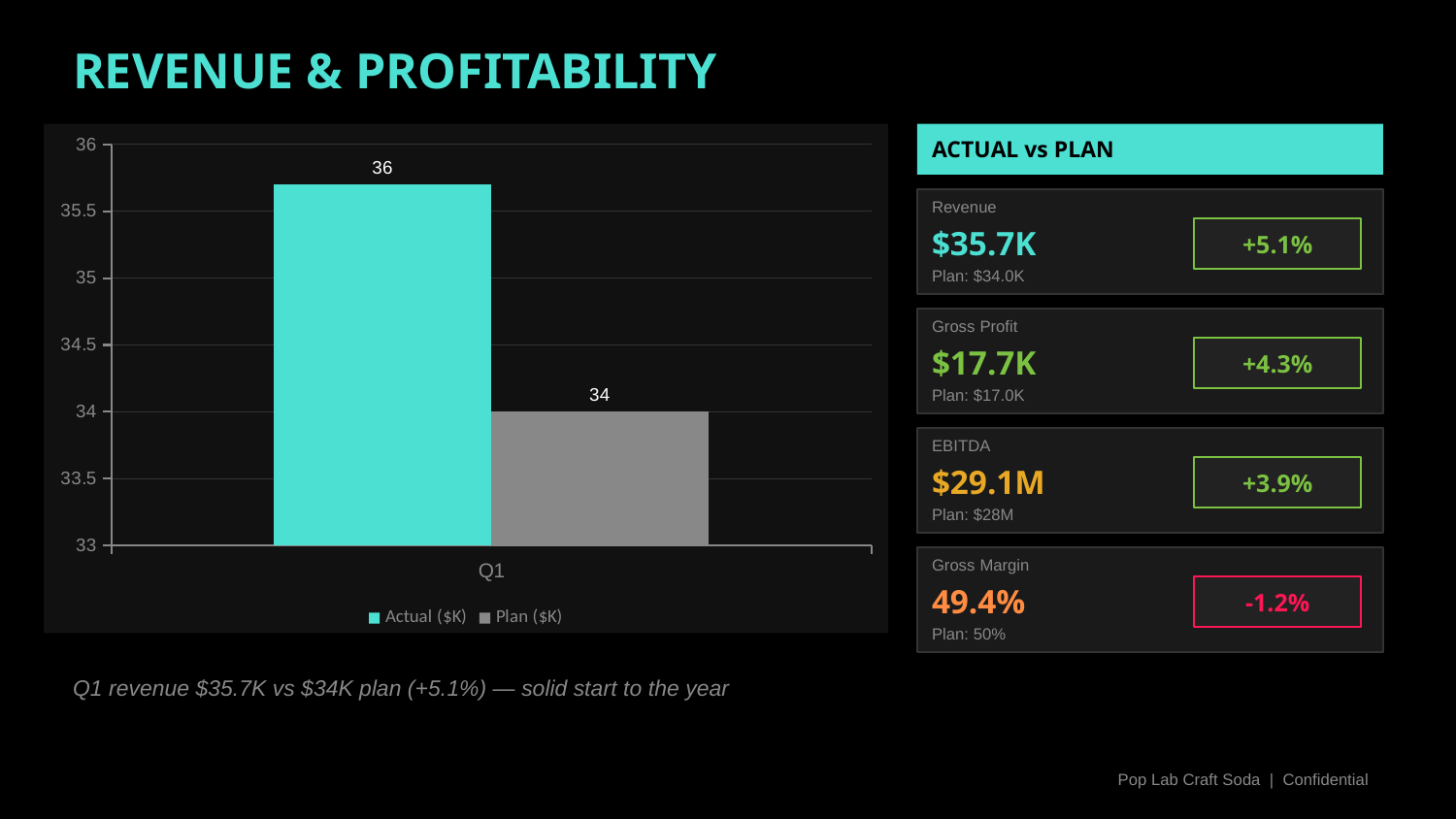
What is the data label on the Actual ($K) bar for Q1? 36 What is the lowest value shown on the chart's y axis? 33 How many categories are shown on the x axis of the chart? 1 What is the data label on the Plan ($K) bar for Q1? 34 What is the category label on the x axis of the chart? Q1 Which series has the taller bar for Q1, Actual ($K) or Plan ($K)? Actual ($K) What colour is the Actual ($K) bar in the chart? teal Is the Plan ($K) bar for Q1 greater or less than 35? less What is the difference between the Actual ($K) and Plan ($K) data labels for Q1? 2 What type of chart is shown on the slide? bar chart Is the Actual ($K) bar for Q1 greater or less than 35? greater How many series does the chart legend list? 2